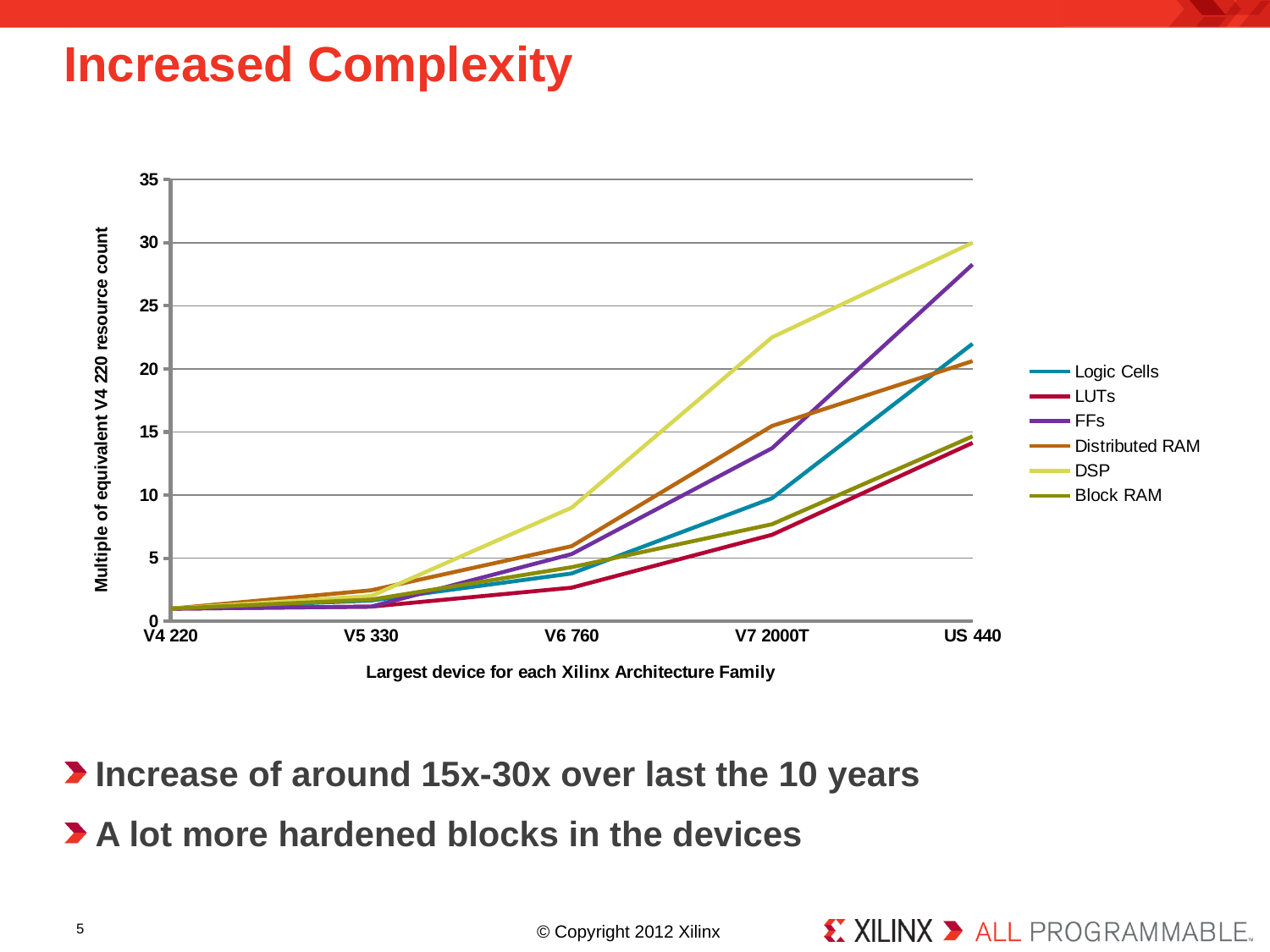
What kind of chart is shown on the slide? line chart What is the x-axis title of the chart? Largest device for each Xilinx Architecture Family Is the value for DSP at V7 2000T greater or less than 20? greater Is the value for DSP at US 440 greater or less than 25? greater At V6 760, which is larger: DSP or LUTs? DSP Do the values for Logic Cells rise or fall from V4 220 to US 440? rise Which series has the highest value at US 440? DSP Is the value for LUTs at V7 2000T greater or less than 10? less How many series does the legend list? 6 At V7 2000T, which is larger: DSP or Logic Cells? DSP How many device categories are shown along the x axis? 5